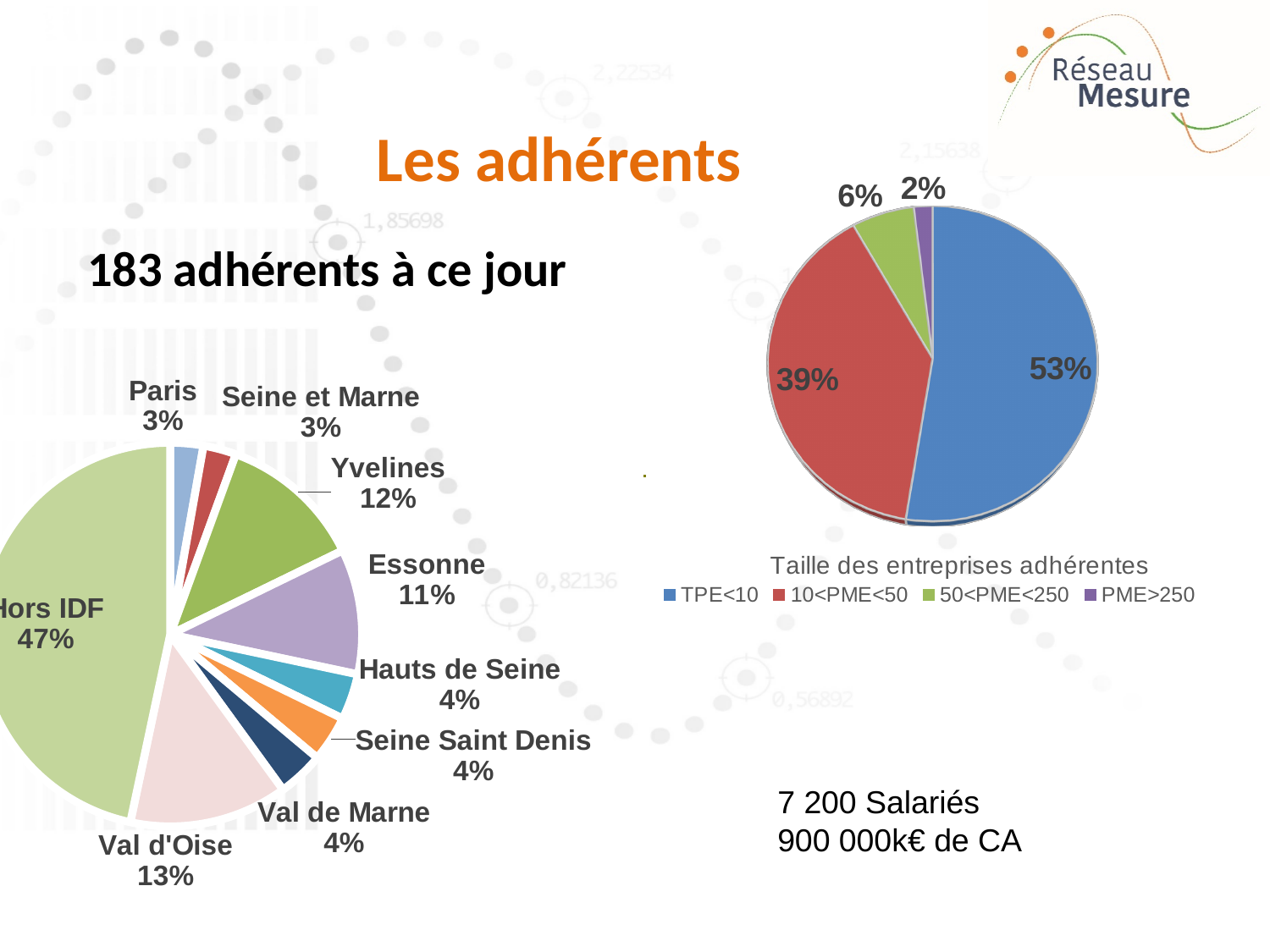
In the pie chart on the left, what share is labelled for Val d'Oise? 13% In the pie chart on the left, what is the difference between the shares of Val d'Oise and Paris? 10% In the chart titled 'Taille des entreprises adhérentes', which category has the smallest share? PME>250 How many slices does the pie chart on the left have? 9 In the pie chart on the left, which is larger, Yvelines or Essonne? Yvelines In the chart titled 'Taille des entreprises adhérentes', what share is shown for TPE<10? 53% How many entries does the legend of the chart titled 'Taille des entreprises adhérentes' list? 4 In the chart titled 'Taille des entreprises adhérentes', what is the difference between the shares of TPE<10 and 10<PME<50? 14% In the chart titled 'Taille des entreprises adhérentes', what share is shown for 10<PME<50? 39% What kind of chart is the chart titled 'Taille des entreprises adhérentes'? Pie chart In the pie chart on the left, which category has the largest share? Hors IDF In the pie chart on the left, what share is labelled for Hors IDF? 47%